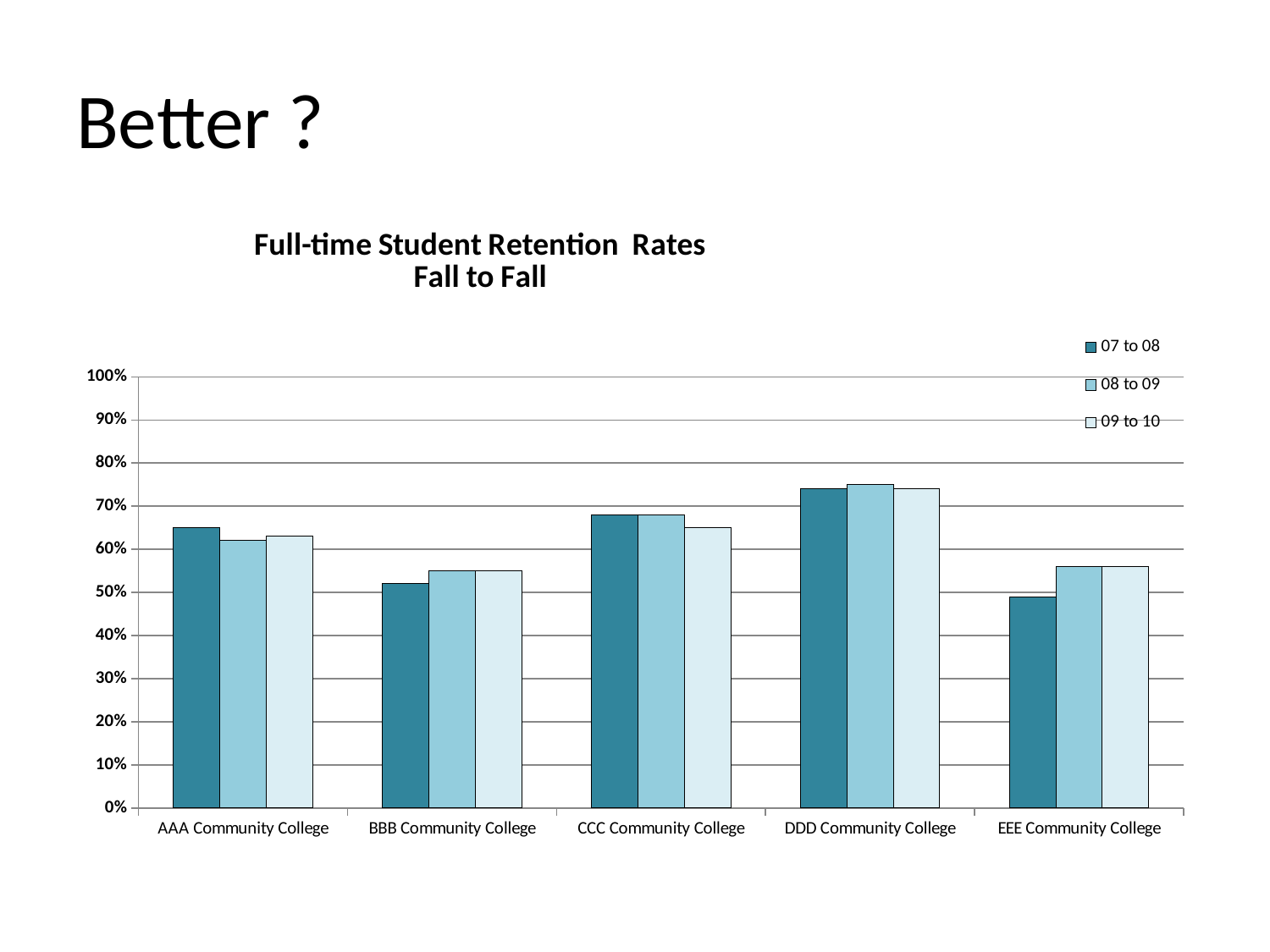
Is the 09 to 10 retention rate for BBB Community College greater or less than 60%? less How many community colleges are shown on the x axis? 5 For 07 to 08, which has the larger retention rate: DDD Community College or BBB Community College? DDD Community College Which community college has the highest retention rate for 09 to 10? DDD Community College What is the title of the chart? Full-time Student Retention Rates Fall to Fall Is the 08 to 09 retention rate for DDD Community College greater or less than 70%? greater What kind of chart is shown on the slide? bar chart Is the 07 to 08 retention rate for AAA Community College greater or less than 60%? greater Which community college has the highest retention rate for 07 to 08? DDD Community College For EEE Community College, did the retention rate rise or fall from 07 to 08 to 08 to 09? rise How many series does the legend list? 3